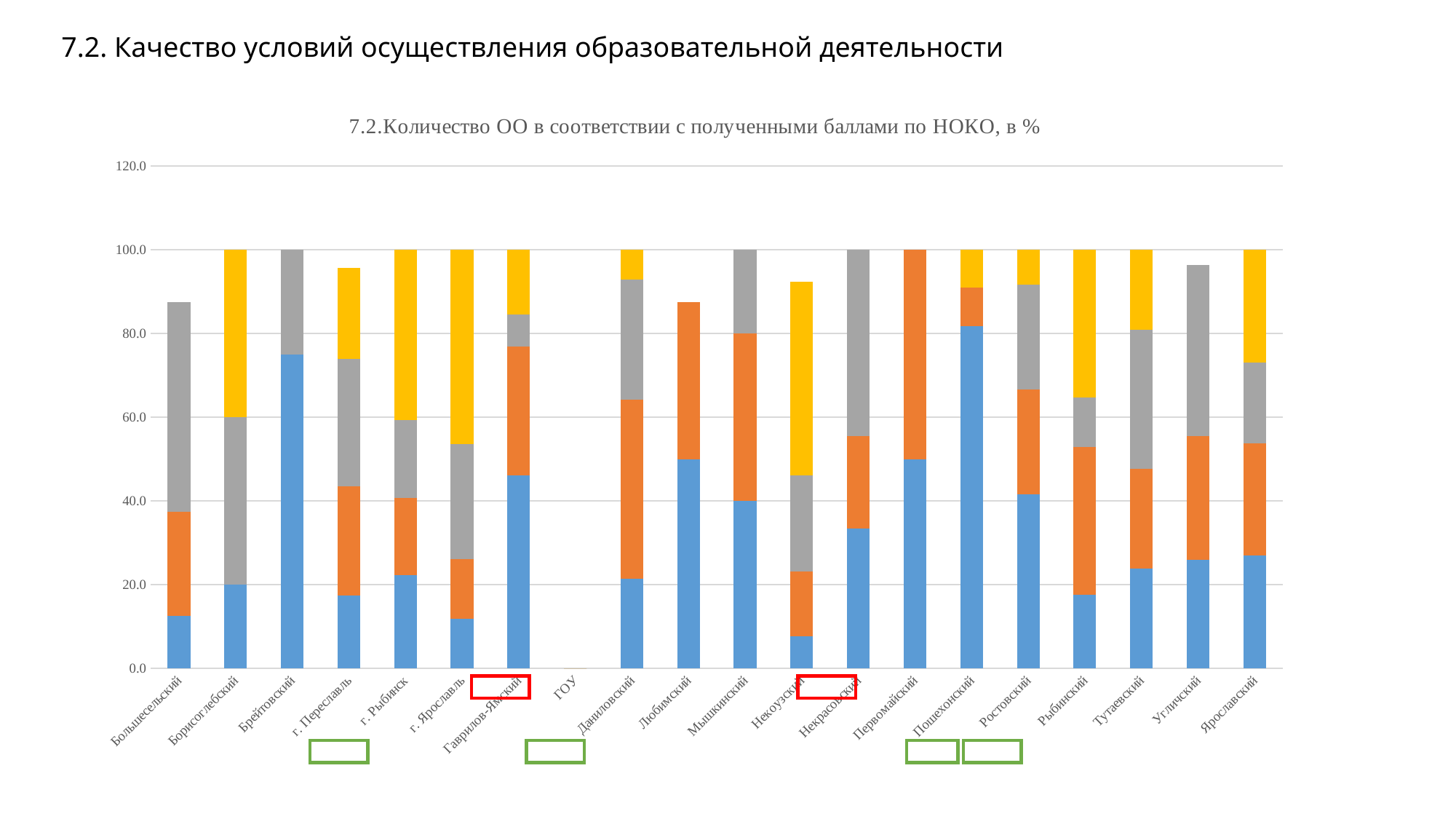
How many differently coloured segments make up the stacked bars? 4 Which category has the tallest blue segment? Пошехонский Which stacked bar is taller in total, Угличский or Большесельский? Угличский Is the blue segment for Брейтовский greater or less than 60? greater What is the title of the chart? 7.2.Количество ОО в соответствии с полученными баллами по НОКО, в % Is the blue segment for Некоузский greater or less than 20? less What kind of chart is shown on the slide? Stacked bar chart Is the total height of the stacked bar for Большесельский greater or less than 100? less How many categories are shown along the x axis of the chart? 20 Which has the larger blue segment, Брейтовский or Большесельский? Брейтовский